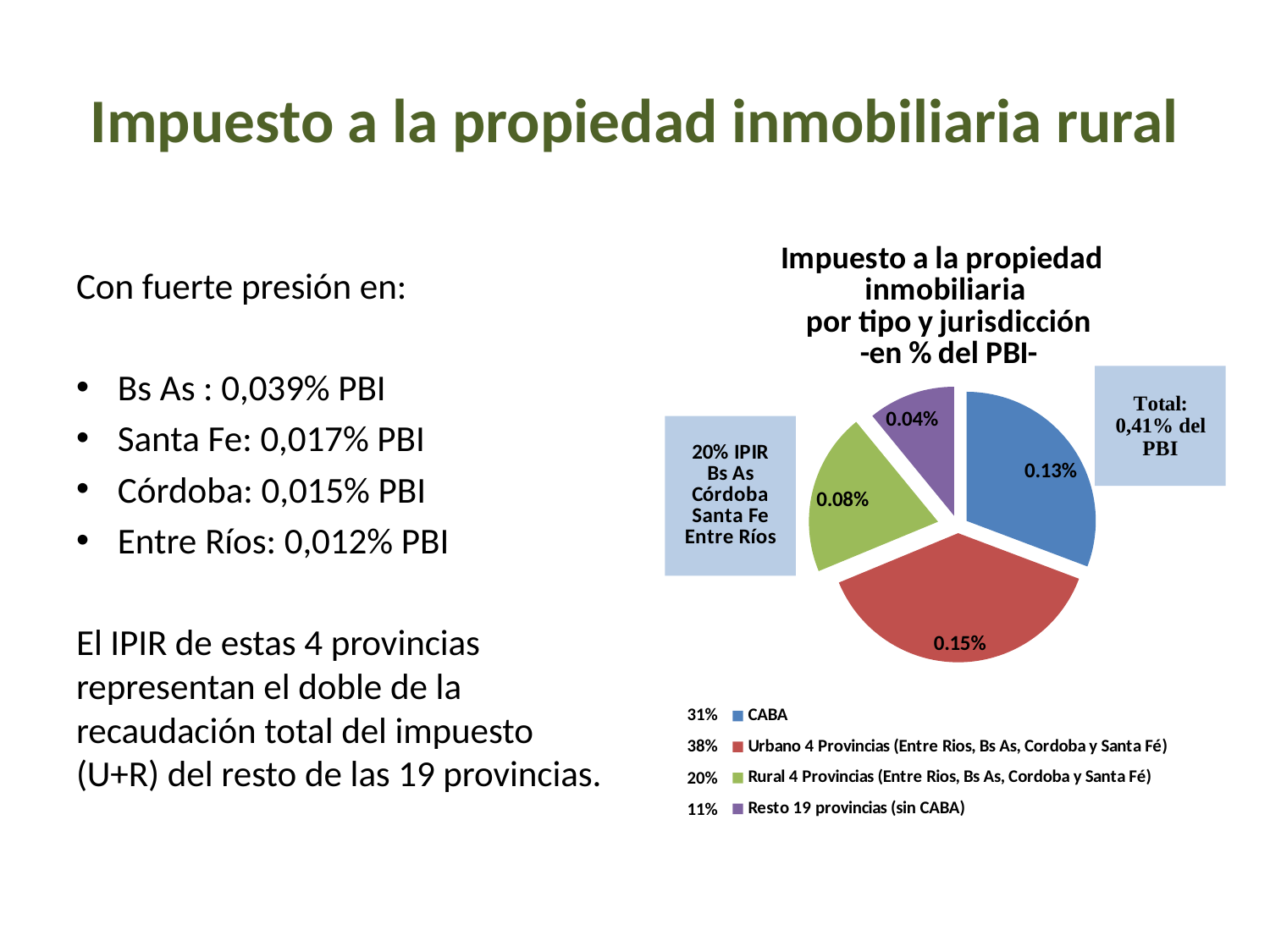
What is the value for Rural 4 Provincias (Entre Rios, Bs As, Cordoba y Santa Fé) in the pie chart? 0.08% What type of chart is shown on the slide? pie chart What is the value for Urbano 4 Provincias (Entre Rios, Bs As, Cordoba y Santa Fé) in the pie chart? 0.15% What is the difference between the Urbano 4 Provincias value and the CABA value in the pie chart? 0.02% How many slices does the pie chart have? 4 Which category has the largest slice in the pie chart? Urbano 4 Provincias (Entre Rios, Bs As, Cordoba y Santa Fé) What is the value for CABA in the pie chart? 0.13% Which is larger in the pie chart: Rural 4 Provincias or Resto 19 provincias (sin CABA)? Rural 4 Provincias What total in % of PBI is shown in the box next to the pie chart? 0,41% del PBI Which category has the smallest slice in the pie chart? Resto 19 provincias (sin CABA) What share of the pie does CABA represent, according to the legend? 31% What is the value for Resto 19 provincias (sin CABA) in the pie chart? 0.04%